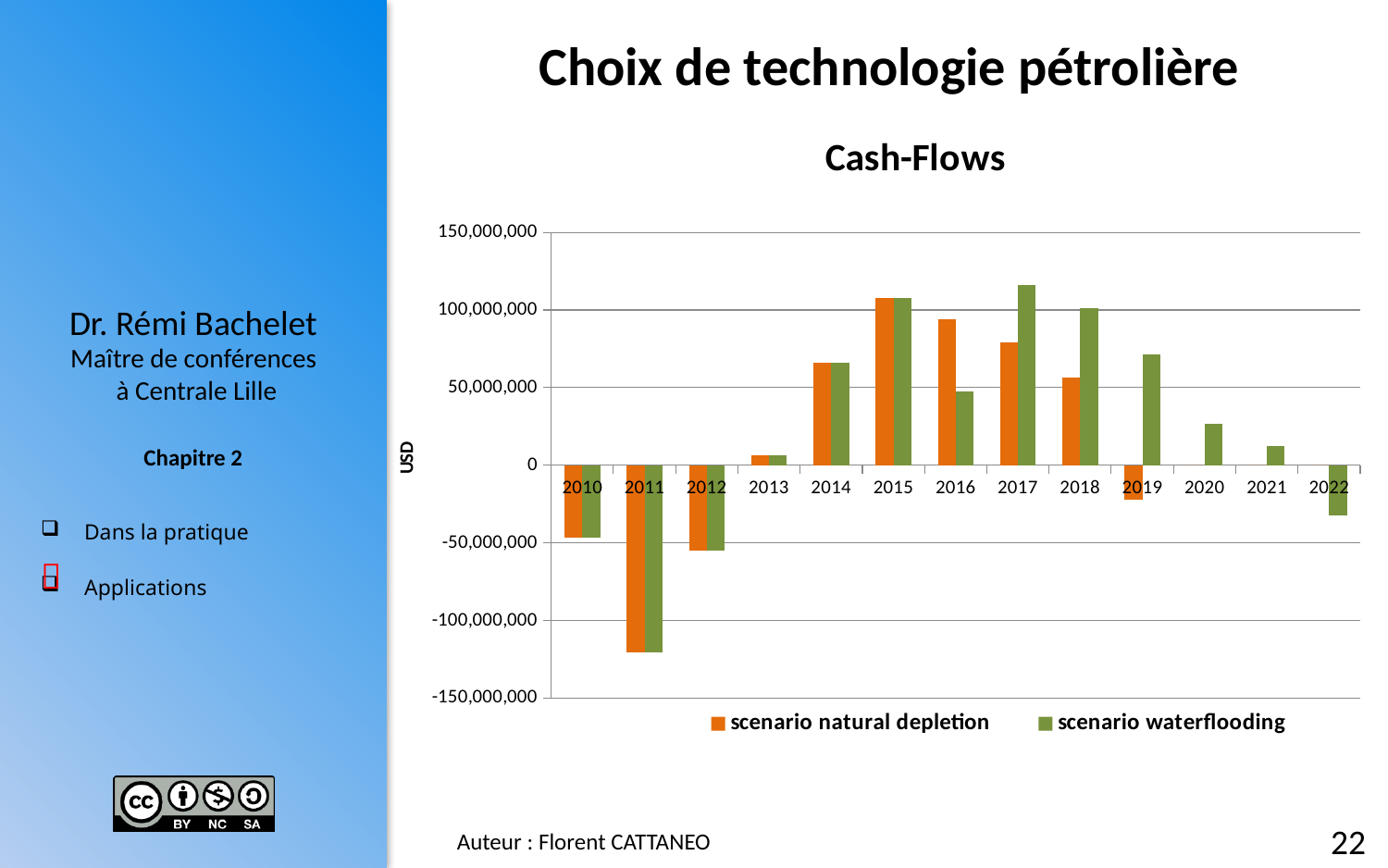
In which year is the cash-flow for scenario natural depletion the highest? 2015 In 2016, which scenario has the larger cash-flow, natural depletion or waterflooding? scenario natural depletion How many years are shown on the x axis of the chart? 13 Is the value for scenario natural depletion in 2015 greater or less than 100,000,000? greater What kind of chart is shown on the slide? bar chart How many series does the legend list? 2 What is the title of the chart? Cash-Flows Is the value for scenario waterflooding in 2022 greater or less than 0? less In which year is the cash-flow for scenario waterflooding the lowest? 2011 What is the label of the vertical axis? USD In which year is the cash-flow for scenario natural depletion the lowest? 2011 Is the value for scenario waterflooding in 2020 greater or less than 50,000,000? less